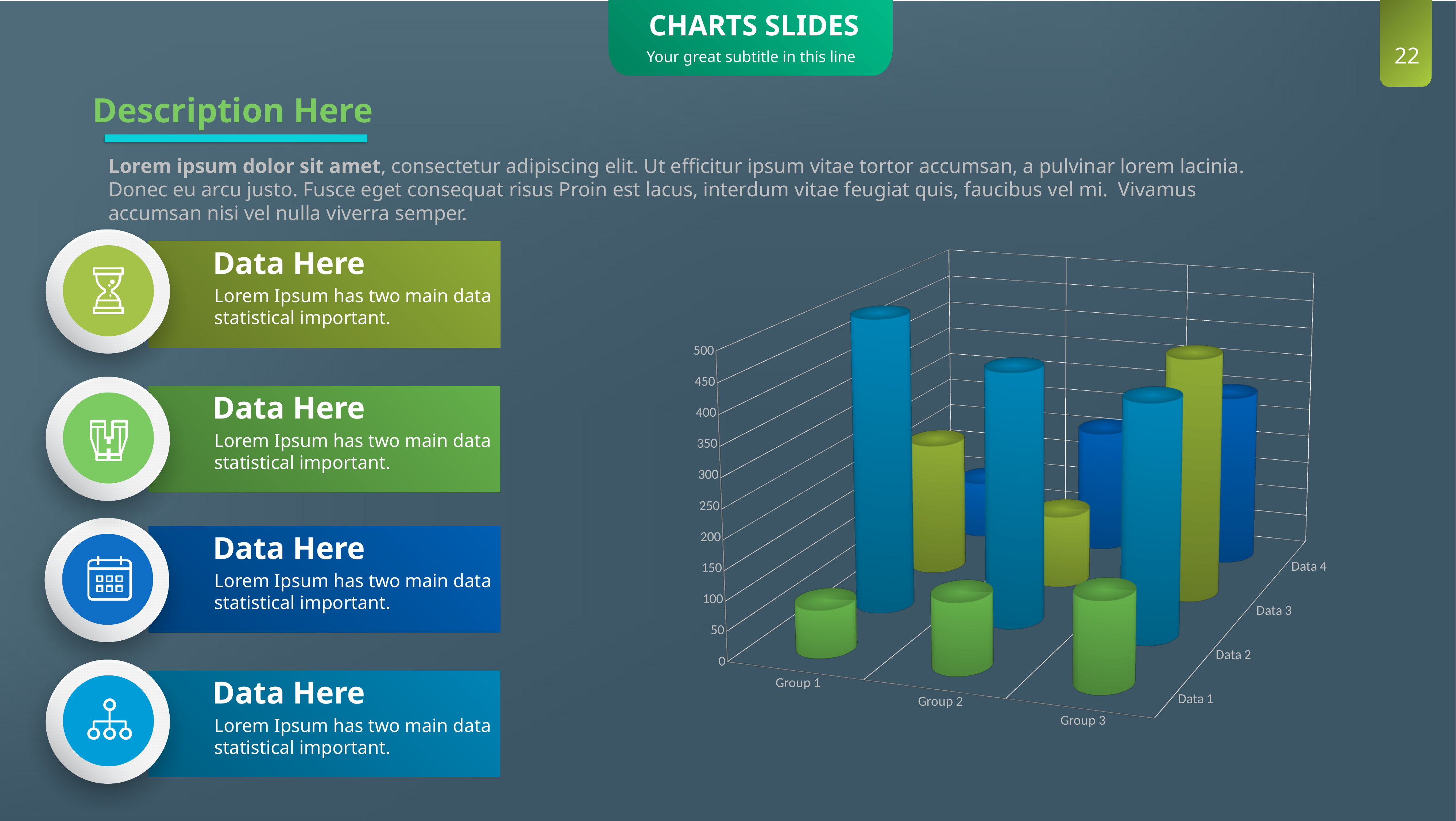
Is the value for Data 2 in Group 1 greater or less than 250? greater In Group 1, which is larger: the value for Data 1 or the value for Data 2? Data 2 What is the highest value shown on the chart's vertical axis? 500 Within the Data 4 series, which group has the lowest value? Group 1 Within the Data 2 series, which group has the highest value? Group 1 How many groups are shown along the horizontal axis of the chart? 3 What kind of chart is shown on the slide? bar chart Within the Data 3 series, which group has the lowest value? Group 2 What are the labels of the three categories on the chart's horizontal axis? Group 1, Group 2, Group 3 How many data series (Data 1 to Data 4) are plotted in the chart? 4 Is the value for Data 1 in Group 1 greater or less than 250? less